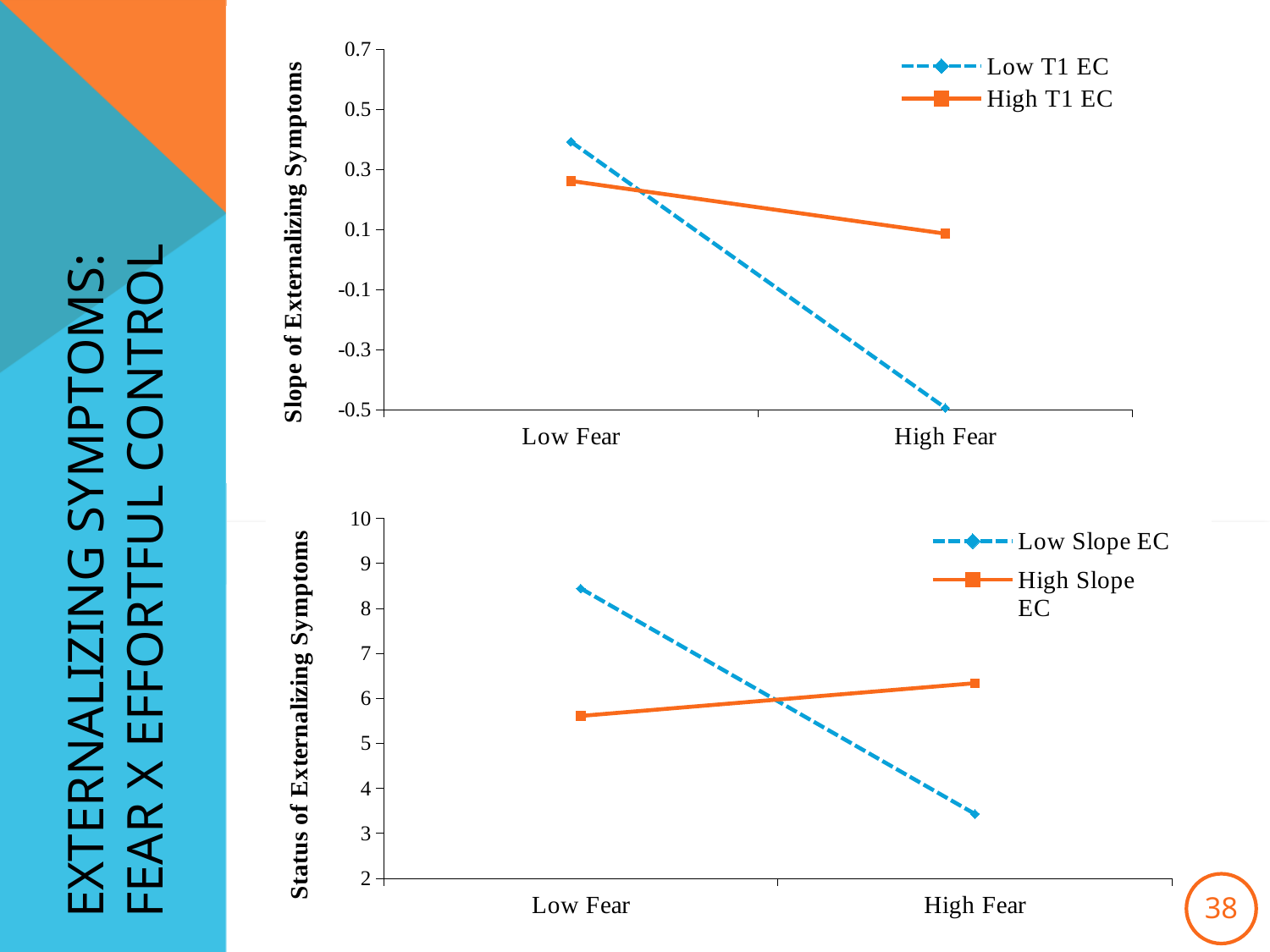
In the bottom chart, does the High Slope EC line rise or fall from Low Fear to High Fear? rise In the top chart, is the value for High T1 EC at High Fear greater or less than 0.3? less In the top chart, which series has the higher value at High Fear, Low T1 EC or High T1 EC? High T1 EC In the top chart, does the Low T1 EC line rise or fall from Low Fear to High Fear? fall In the bottom chart, is the value for Low Slope EC at High Fear greater or less than 4? less How many series does the legend of the top chart list? 2 What kind of chart is the top chart on the slide? line chart In the bottom chart, which series has the higher value at Low Fear, Low Slope EC or High Slope EC? Low Slope EC In the top chart, how many categories are shown on the x axis? 2 In the top chart, is the value for Low T1 EC at Low Fear greater or less than 0.3? greater What is the y-axis title of the bottom chart? Status of Externalizing Symptoms